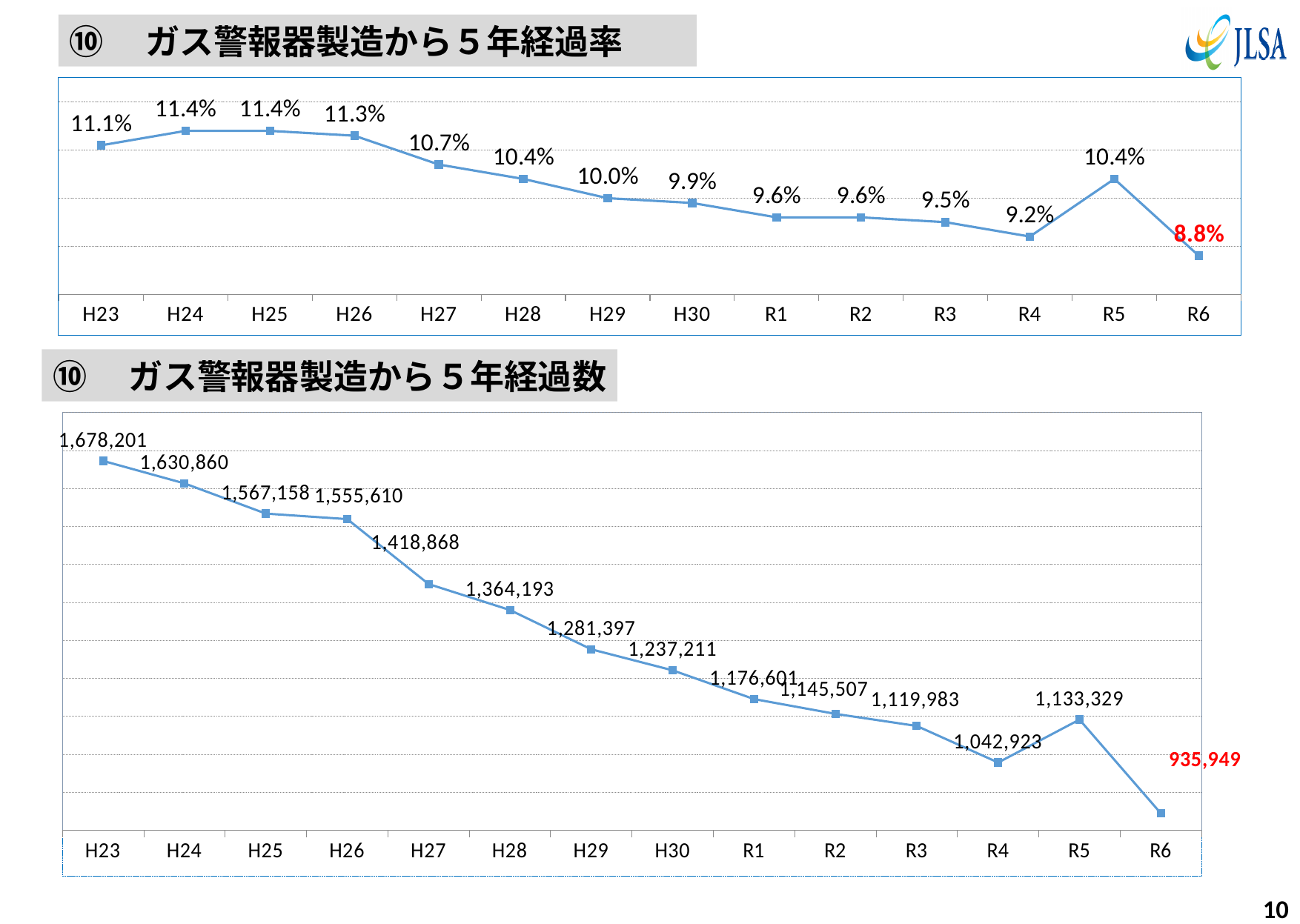
In the bottom chart (ガス警報器製造から５年経過数), what is the value for H23? 1,678,201 What kind of chart is the bottom chart (ガス警報器製造から５年経過数)? Line chart In the top chart (ガス警報器製造から５年経過率), what is the value for H27? 10.7% In the top chart (ガス警報器製造から５年経過率), how many data points are plotted? 14 In the bottom chart (ガス警報器製造から５年経過数), what is the difference between the values for H23 and R6? 742,252 In the bottom chart (ガス警報器製造から５年経過数), what is the overall trend of the values from H23 to R6? Falling In the bottom chart (ガス警報器製造から５年経過数), which category has the highest value? H23 In the top chart (ガス警報器製造から５年経過率), what is the difference between the values for R5 and R4? 1.2 percentage points In the top chart (ガス警報器製造から５年経過率), which category has the lowest value? R6 In the top chart (ガス警報器製造から５年経過率), which is larger, the value for H23 or the value for R5? H23 In the bottom chart (ガス警報器製造から５年経過数), what is the value for R4? 1,042,923 In the top chart (ガス警報器製造から５年経過率), what is the value for R6? 8.8%